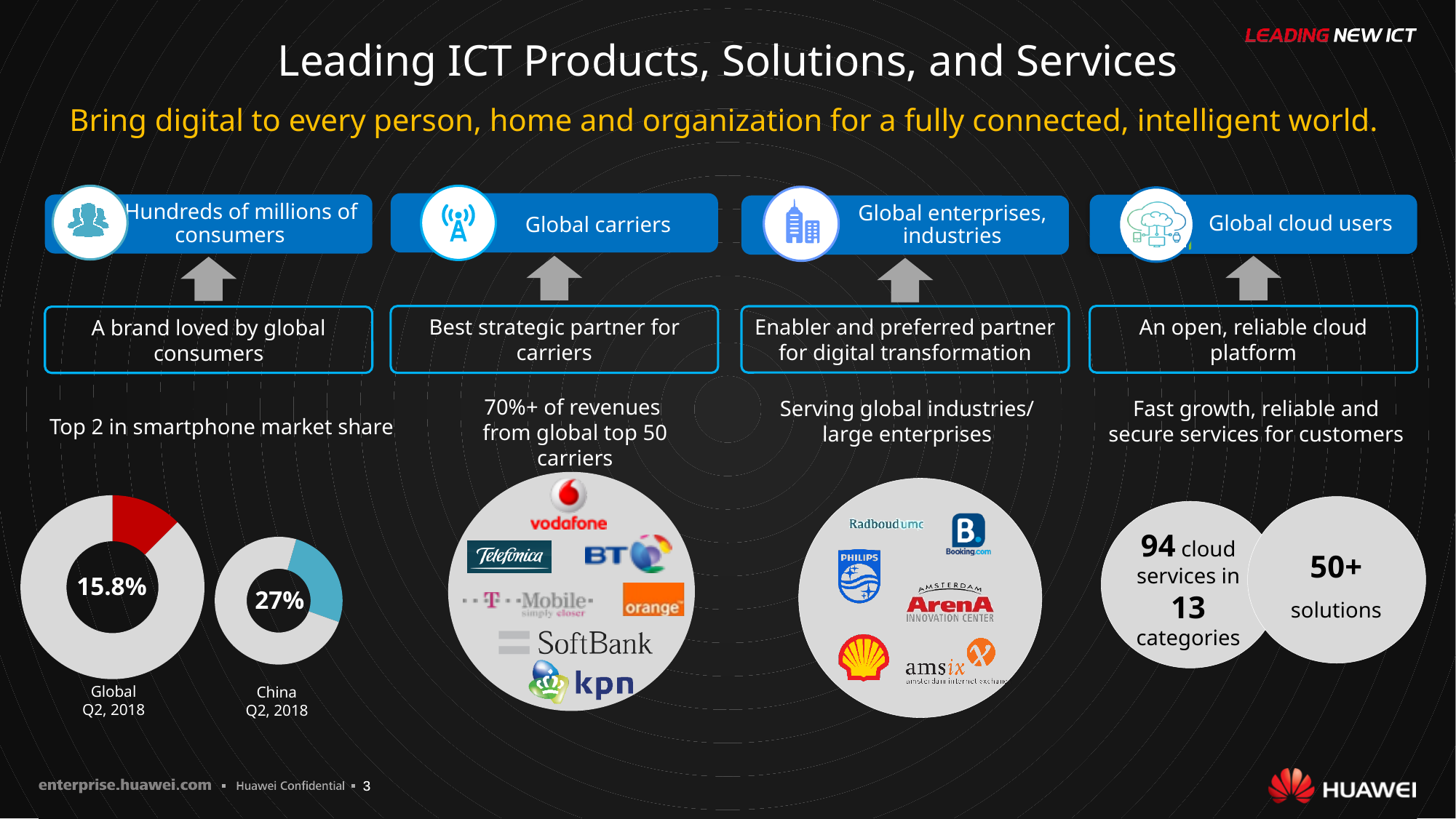
In the 'Global Q2, 2018' donut chart, what smartphone market share value is shown? 15.8% In the 'Global Q2, 2018' donut chart, is the highlighted share greater or less than 20%? less Of the two smartphone market share donut charts, which one shows the lowest value? Global Q2, 2018 What is the difference between the China Q2, 2018 market share and the Global Q2, 2018 market share shown in the donut charts? 11.2% In the 'China Q2, 2018' donut chart, what colour is the highlighted slice? Light blue What type of chart is used to show the smartphone market share figures under 'Top 2 in smartphone market share'? Pie (donut) chart In the 'China Q2, 2018' donut chart, what smartphone market share value is shown? 27% Comparing the two smartphone market share donut charts, which shows the larger value, Global or China? China How many donut charts are shown under 'Top 2 in smartphone market share'? 2 In the 'China Q2, 2018' donut chart, what share of the whole does the highlighted slice represent? 27% In the 'Global Q2, 2018' donut chart, what colour is the highlighted slice? Red